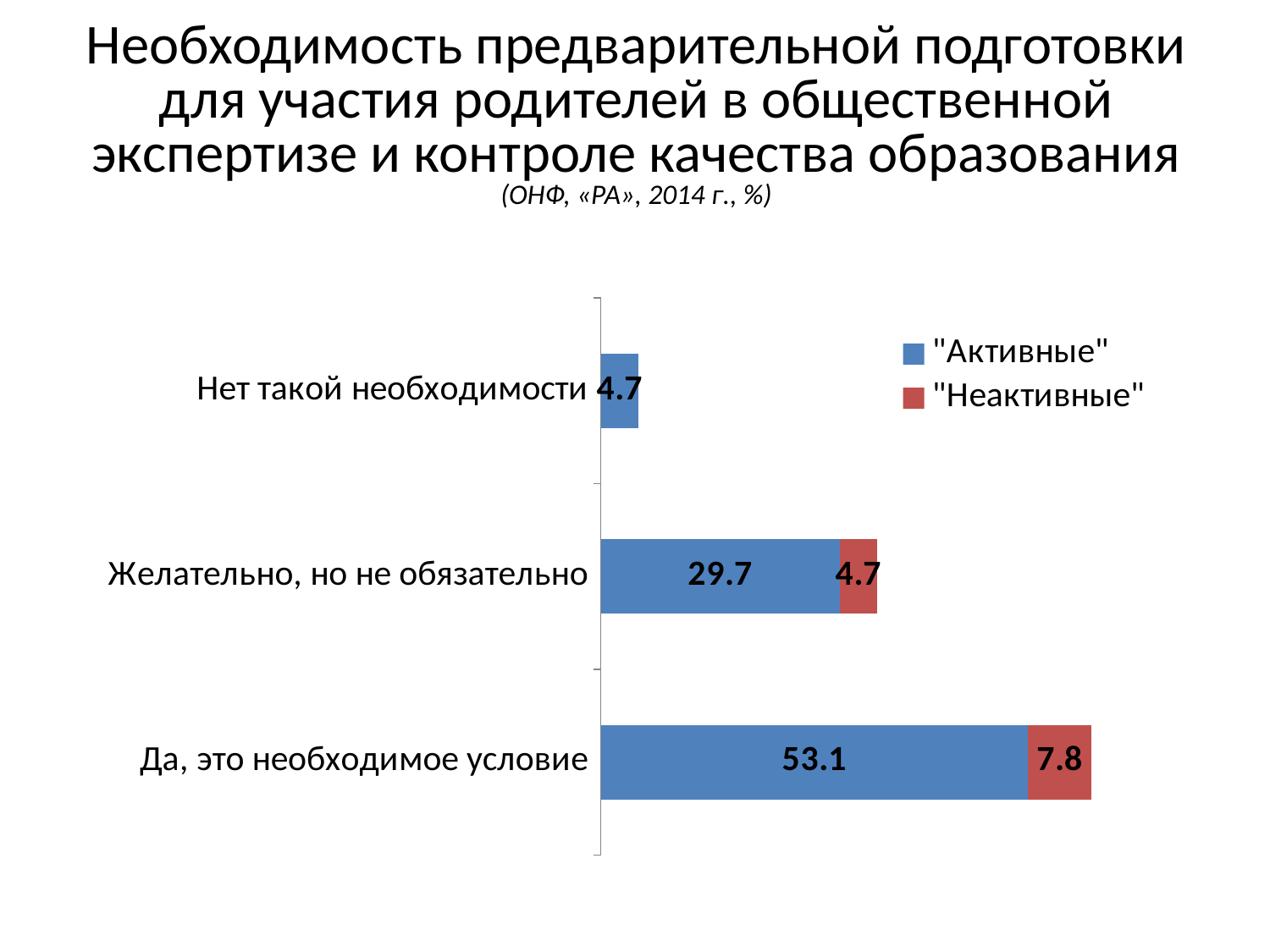
What is the value for "Неактивные" in the category "Да, это необходимое условие"? 7.8 What kind of chart is shown on the slide? Stacked bar chart What is the value for "Неактивные" in the category "Желательно, но не обязательно"? 4.7 What is the total of the stacked bar for "Да, это необходимое условие"? 60.9 Which category has the lowest value for "Активные"? Нет такой необходимости What is the difference between the "Активные" values for "Да, это необходимое условие" and "Желательно, но не обязательно"? 23.4 Which category has the highest value for "Активные"? Да, это необходимое условие What is the value for "Активные" in the category "Нет такой необходимости"? 4.7 What is the value for "Активные" in the category "Желательно, но не обязательно"? 29.7 What is the value for "Активные" in the category "Да, это необходимое условие"? 53.1 Which is larger: the "Неактивные" value for "Да, это необходимое условие" or for "Желательно, но не обязательно"? Да, это необходимое условие How many series does the legend list? 2